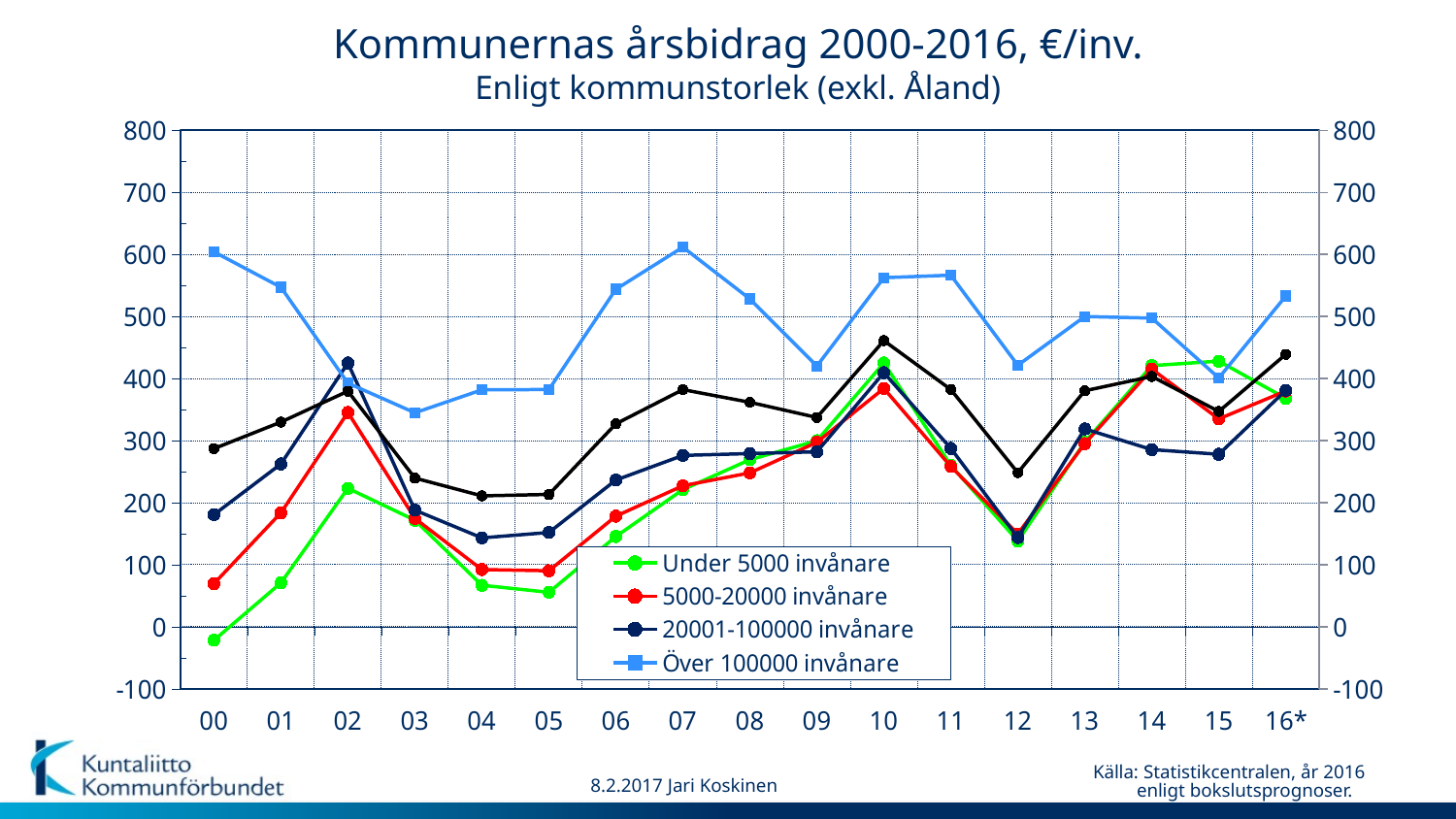
In 02, which is higher: Under 5000 invånare or 5000-20000 invånare? 5000-20000 invånare Is the value for 20001-100000 invånare in 02 greater or less than 400? greater In which year is the value for Under 5000 invånare lowest? 00 Is the value for Över 100000 invånare in 00 greater or less than 500? greater What is the main title of the chart? Kommunernas årsbidrag 2000-2016, €/inv. How many series does the legend list? 4 How many years are plotted along the x axis? 17 Is the value for 5000-20000 invånare in 12 greater or less than 200? less Does the value for Över 100000 invånare rise or fall from 00 to 03? fall What kind of chart is shown on the slide? line chart In 15, which is higher: Under 5000 invånare or 5000-20000 invånare? Under 5000 invånare